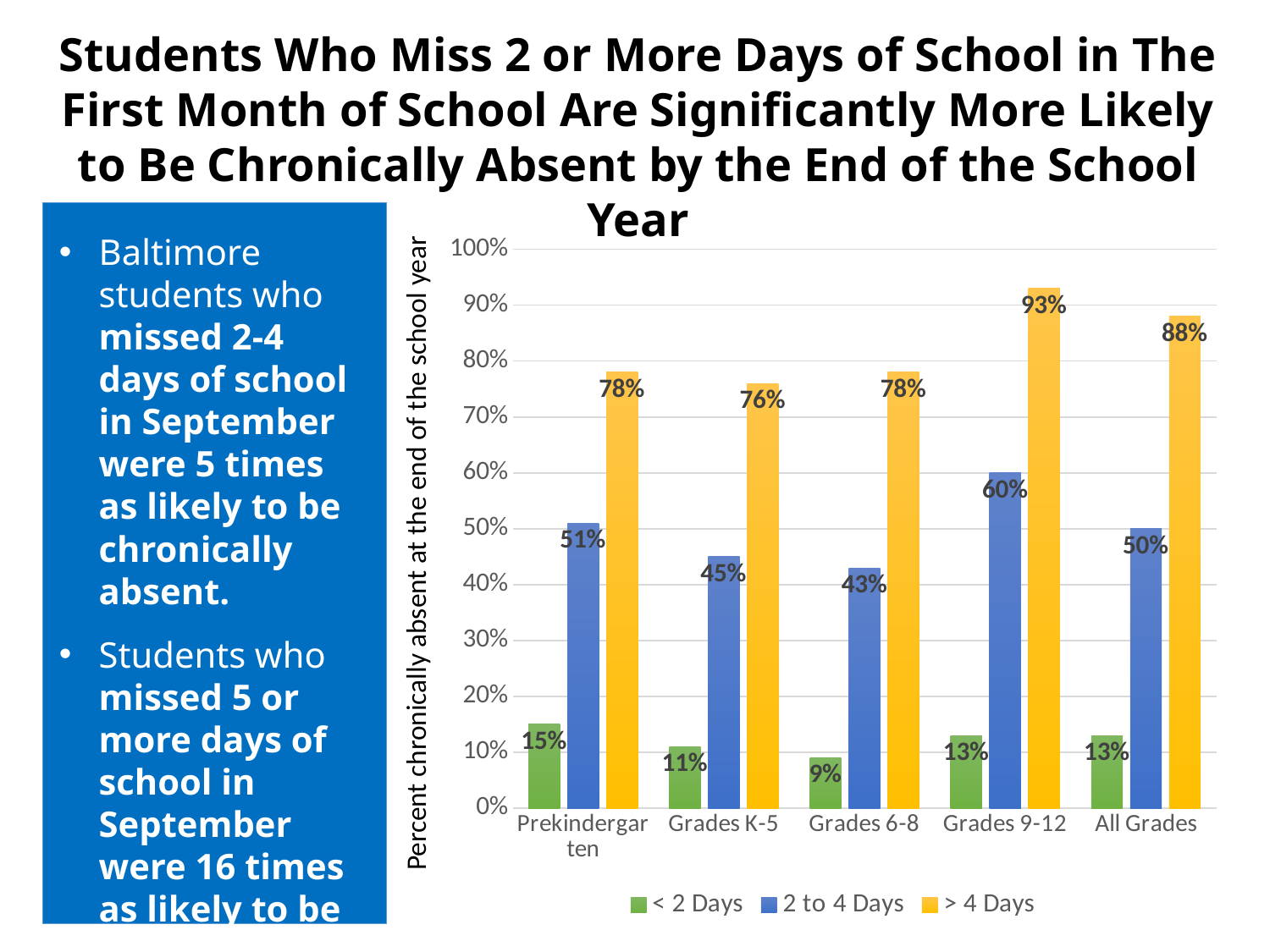
How many categories are shown on the x axis? 5 What is the difference between the "> 4 Days" and "2 to 4 Days" values for All Grades? 38% What is the value for the "< 2 Days" series for Grades 6-8? 9% Which category has the lowest value for the "< 2 Days" series? Grades 6-8 Which is larger: the "2 to 4 Days" value for Grades K-5 or for Grades 6-8? Grades K-5 Is the "2 to 4 Days" value for Grades 9-12 greater or less than 50%? greater What kind of chart is shown on the slide? bar chart Which category has the highest value for the "> 4 Days" series? Grades 9-12 What is the label of the vertical axis? Percent chronically absent at the end of the school year What is the value for the "> 4 Days" series for Grades 9-12? 93% How many series does the legend list? 3 What is the value for the "2 to 4 Days" series for Prekindergarten? 51%